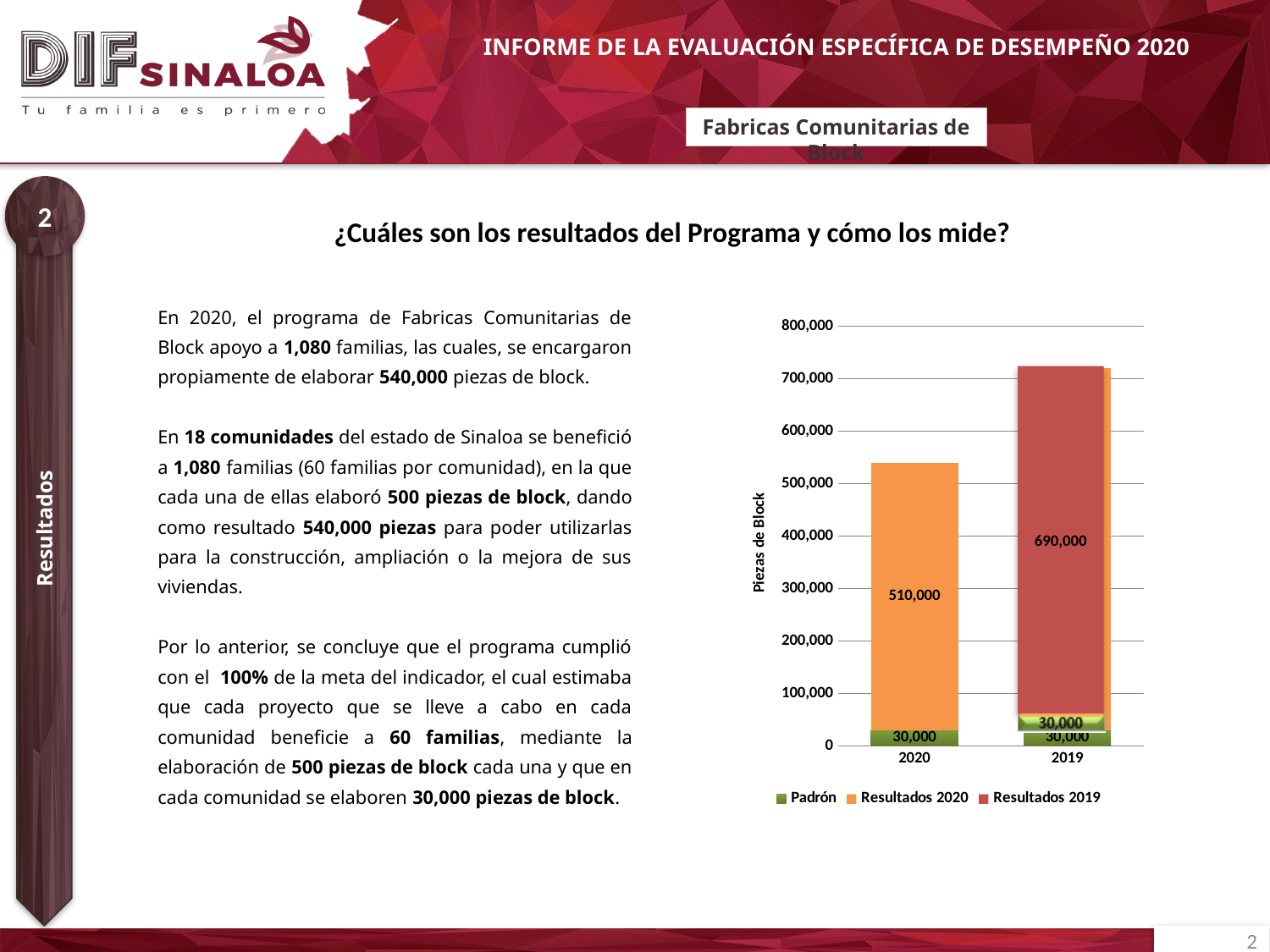
What is the total of the stacked bar for 2020? 540,000 Which is larger, the Resultados 2019 segment for 2019 or the Resultados 2020 segment for 2020? Resultados 2019 segment for 2019 How many series does the chart legend list? 3 What is the value of the Padrón segment for 2020? 30,000 Which category has the taller stacked bar, 2020 or 2019? 2019 What is the difference between the Resultados 2019 segment for 2019 (690,000) and the Resultados 2020 segment for 2020 (510,000)? 180,000 What kind of chart is shown on the slide? bar chart Is the total height of the 2019 bar greater or less than 700,000? greater How many categories are shown on the x axis of the chart? 2 What is the value of the Resultados 2019 segment for 2019? 690,000 What is the title of the chart's vertical axis? Piezas de Block What is the value of the Resultados 2020 segment for 2020? 510,000